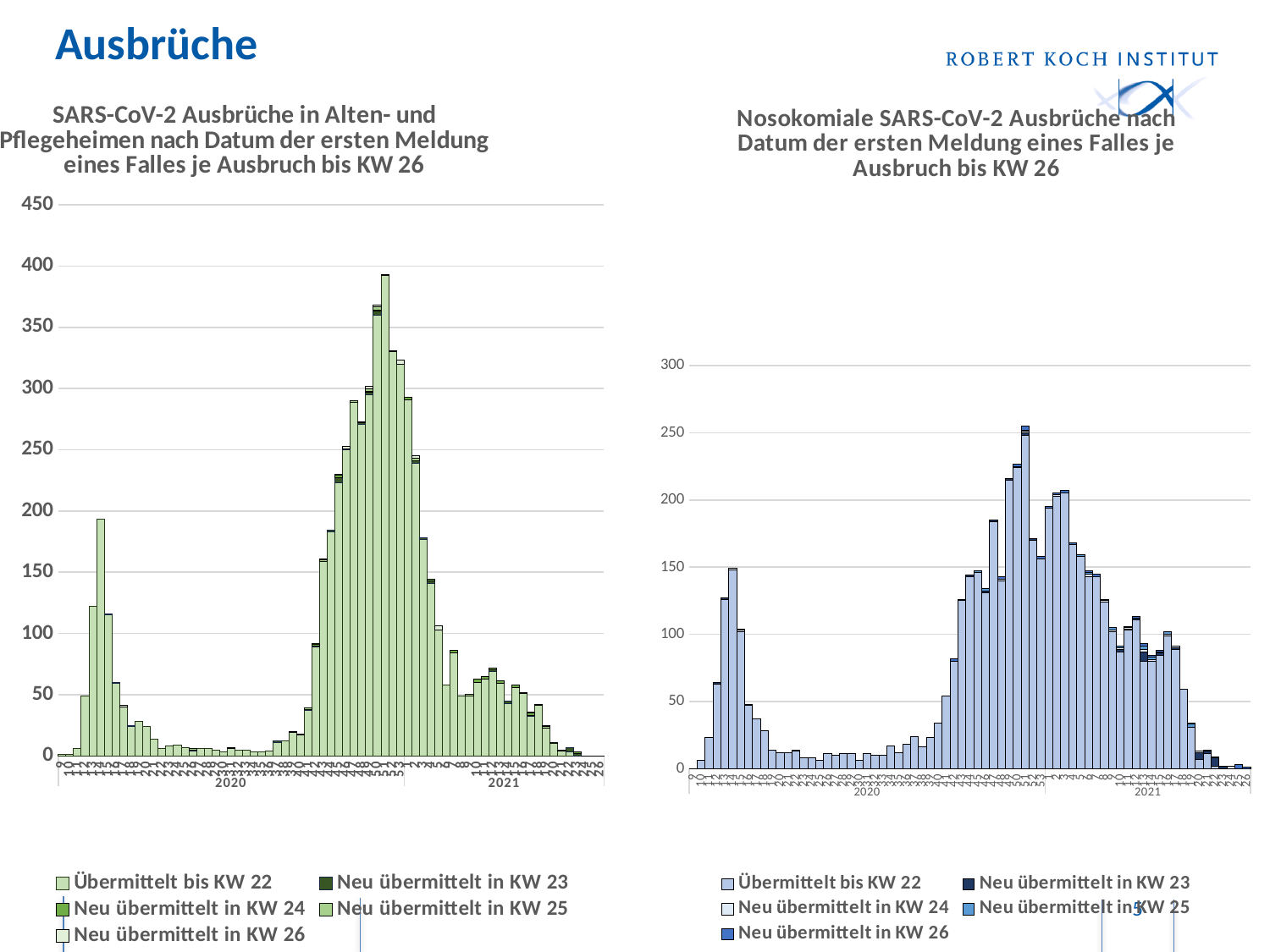
What kind of chart is the right chart, 'Nosokomiale SARS-CoV-2 Ausbrüche'? Stacked bar chart In the left chart, is the value of the tallest bar in the first (spring 2020) wave greater or less than 150? greater What kind of chart is the left chart, 'SARS-CoV-2 Ausbrüche in Alten- und Pflegeheimen'? Stacked bar chart In the right chart, is the value of the tallest bar in the first (spring 2020) wave greater or less than 200? less How many series does the legend of the right chart list? 5 In the left chart, do the values rise or fall from the peak in late 2020 through the end of the 2021 period? fall What is the highest value shown on the y axis of the left chart? 450 In the left chart, in which year does the tallest bar occur? 2020 How many series does the legend of the left chart list? 5 In the right chart, is the value of the tallest bar greater or less than 200? greater